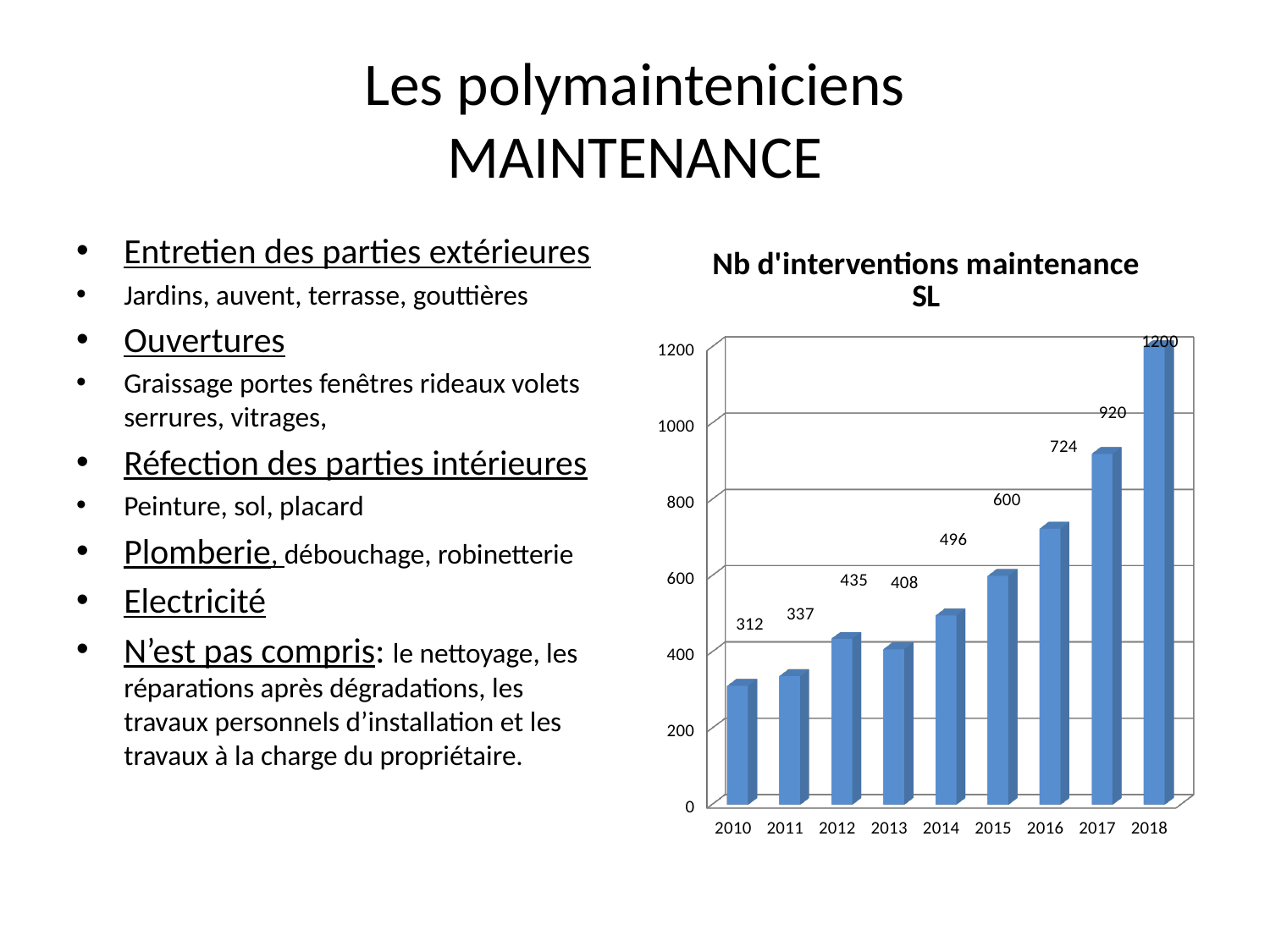
Which year has the lowest number of maintenance interventions? 2010 What is the number of maintenance interventions in 2014? 496 What is the difference between the number of interventions in 2012 and in 2013? 27 What is the title of the chart? Nb d'interventions maintenance SL Which year has the highest number of maintenance interventions? 2018 What is the difference between the number of interventions in 2018 and in 2017? 280 How many years are shown on the x axis of the chart? 9 Which year has more interventions, 2012 or 2013? 2012 Is the value for 2016 greater or less than 800? less What is the number of maintenance interventions in 2017? 920 What kind of chart is shown on the slide? bar chart Do the values generally rise or fall from 2010 to 2018? rise